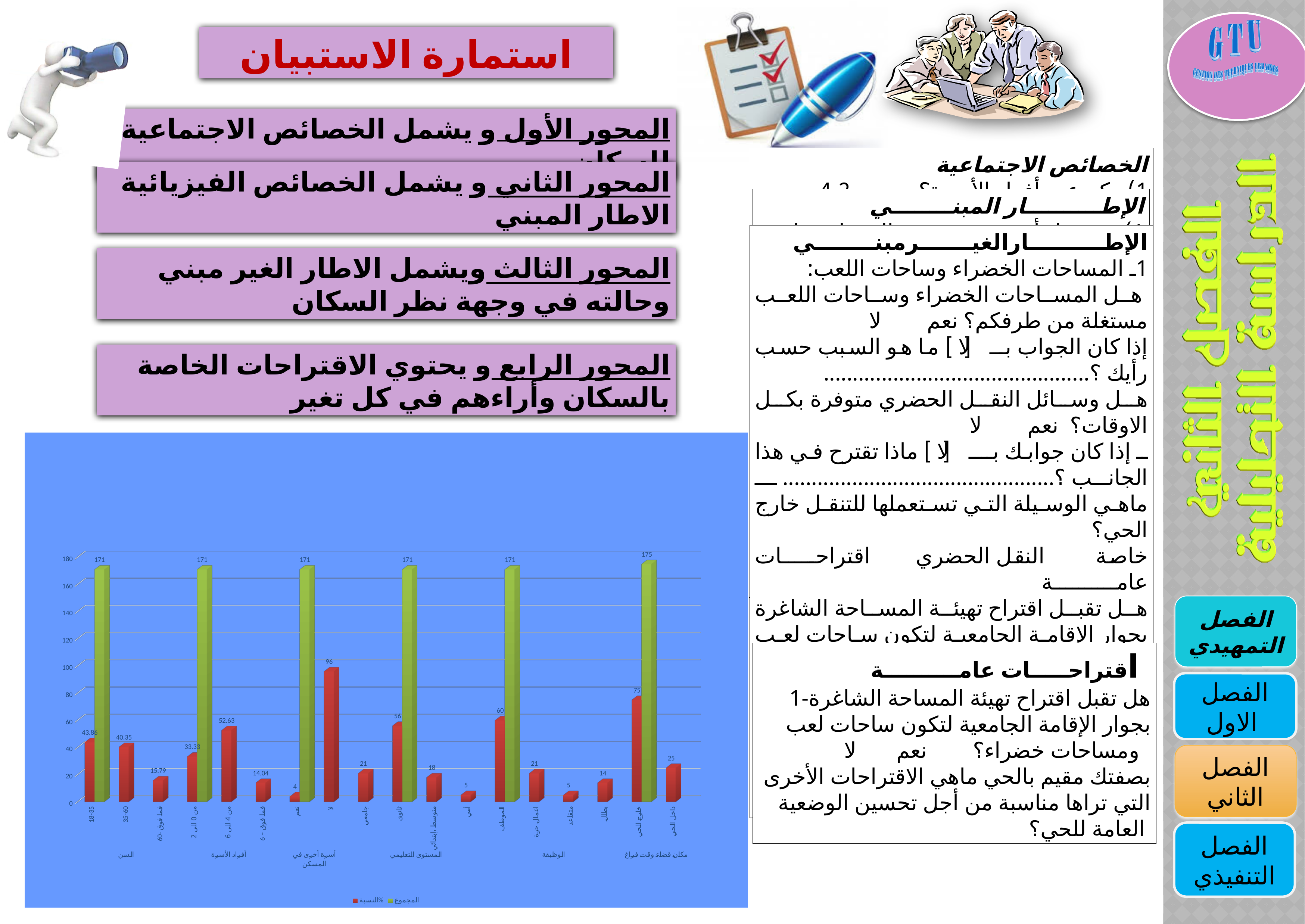
In the bar chart, what is the difference between the النسبة% values for خارج الحي and داخل الحي? 50 What kind of chart is shown at the bottom left of the slide? bar chart In the bar chart, which category has the highest النسبة% value? لا How many series does the legend of the bar chart list? 2 In the bar chart, what is the المجموع value for the category خارج الحي? 175 What are the two series named in the legend of the bar chart? المجموع and النسبة% In the bar chart, what is the difference between the النسبة% values for 18-35 and 35-60? 3.51 In the bar chart, which is larger: the النسبة% value for ثانوي or for جامعي? ثانوي In the bar chart, what is the النسبة% value for the category لا under أسرة أخرى في المسكن? 96 In the bar chart, what is the النسبة% value for the category 18-35? 43.86 In the bar chart, what is the النسبة% value for the category الموظف? 60 In the bar chart, is the المجموع value for 18-35 greater or less than 160? greater